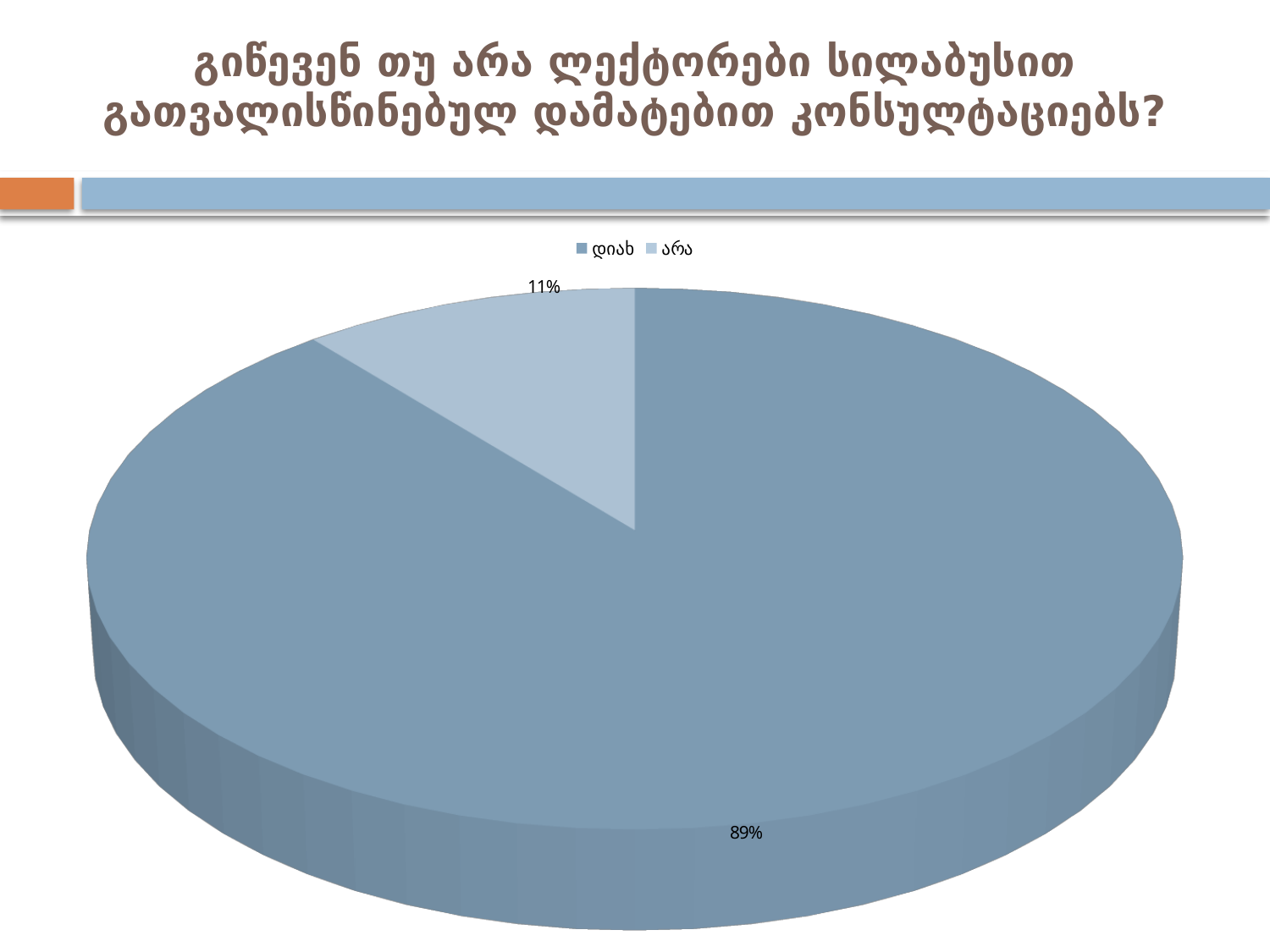
How many slices does the pie chart have? 2 What is the difference between the დიახ and არა slices? 78% How many entries does the legend list? 2 What is the title of the slide above the chart? გიწევენ თუ არა ლექტორები სილაბუსით გათვალისწინებულ დამატებით კონსულტაციებს? What share of the pie does the არა slice represent? 11% What kind of chart is shown on the slide? pie chart Which slice of the pie chart is the largest? დიახ What is the value for არა in the pie chart? 11% What is the value for დიახ in the pie chart? 89% Which slice of the pie chart is the smallest? არა Which is larger, the დიახ slice or the არა slice? დიახ Which legend entry is shown with the lighter colour? არა